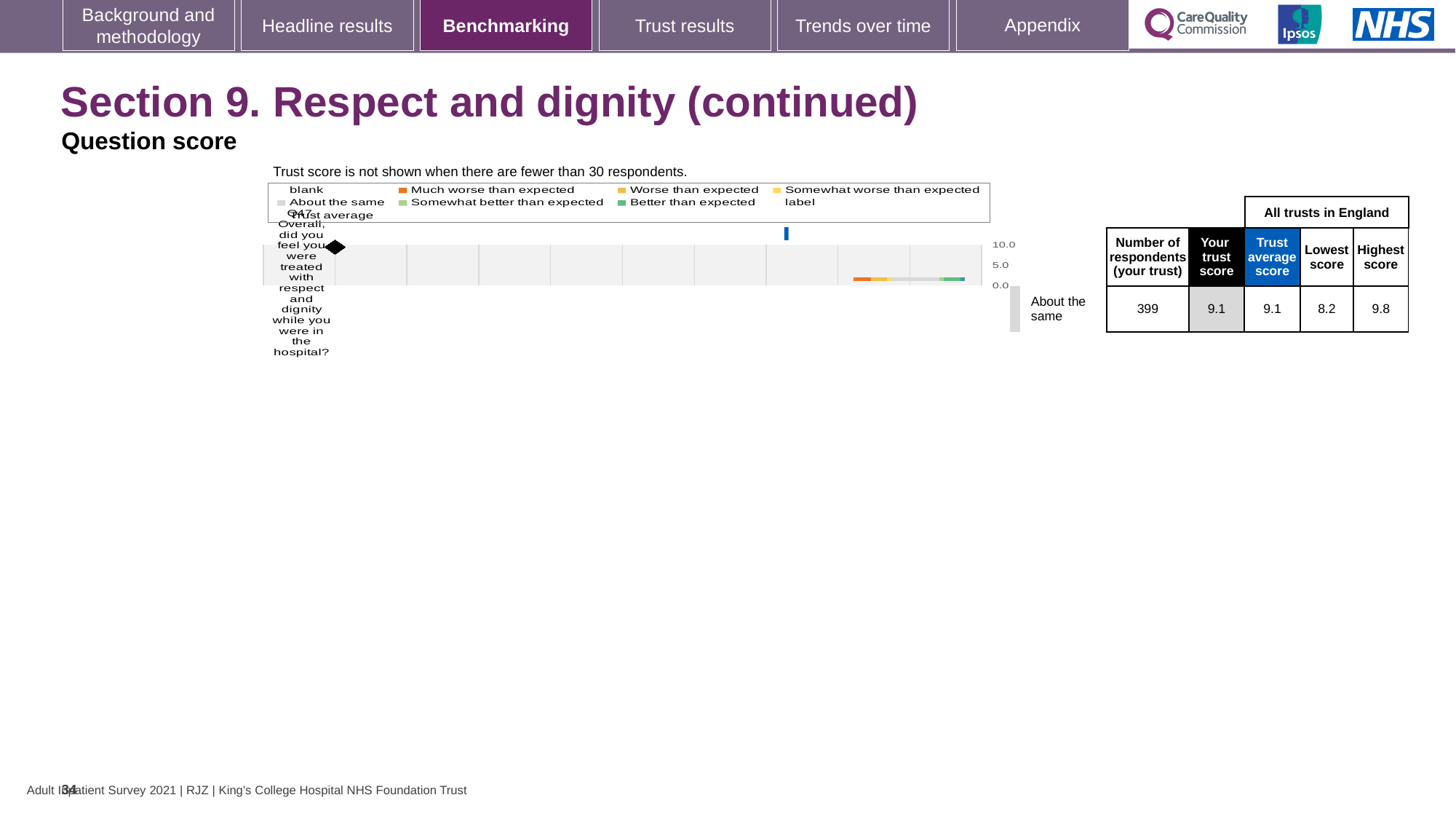
What is the trust average score for Q47? 9.1 How many entries does the chart legend list? 9 What benchmark category is shown next to the chart for Q47? About the same What is the highest score among all trusts in England for Q47? 9.8 What is the lowest score among all trusts in England for Q47? 8.2 How many questions are plotted in the chart? 1 What is the number of respondents (your trust) for Q47? 399 Is your trust score for Q47 higher, lower or equal to the trust average score? equal Which question number is plotted in the chart? Q47 What is the difference between the highest score and the lowest score for Q47? 1.6 What kind of chart is shown on the slide? bar chart What is your trust score for Q47? 9.1